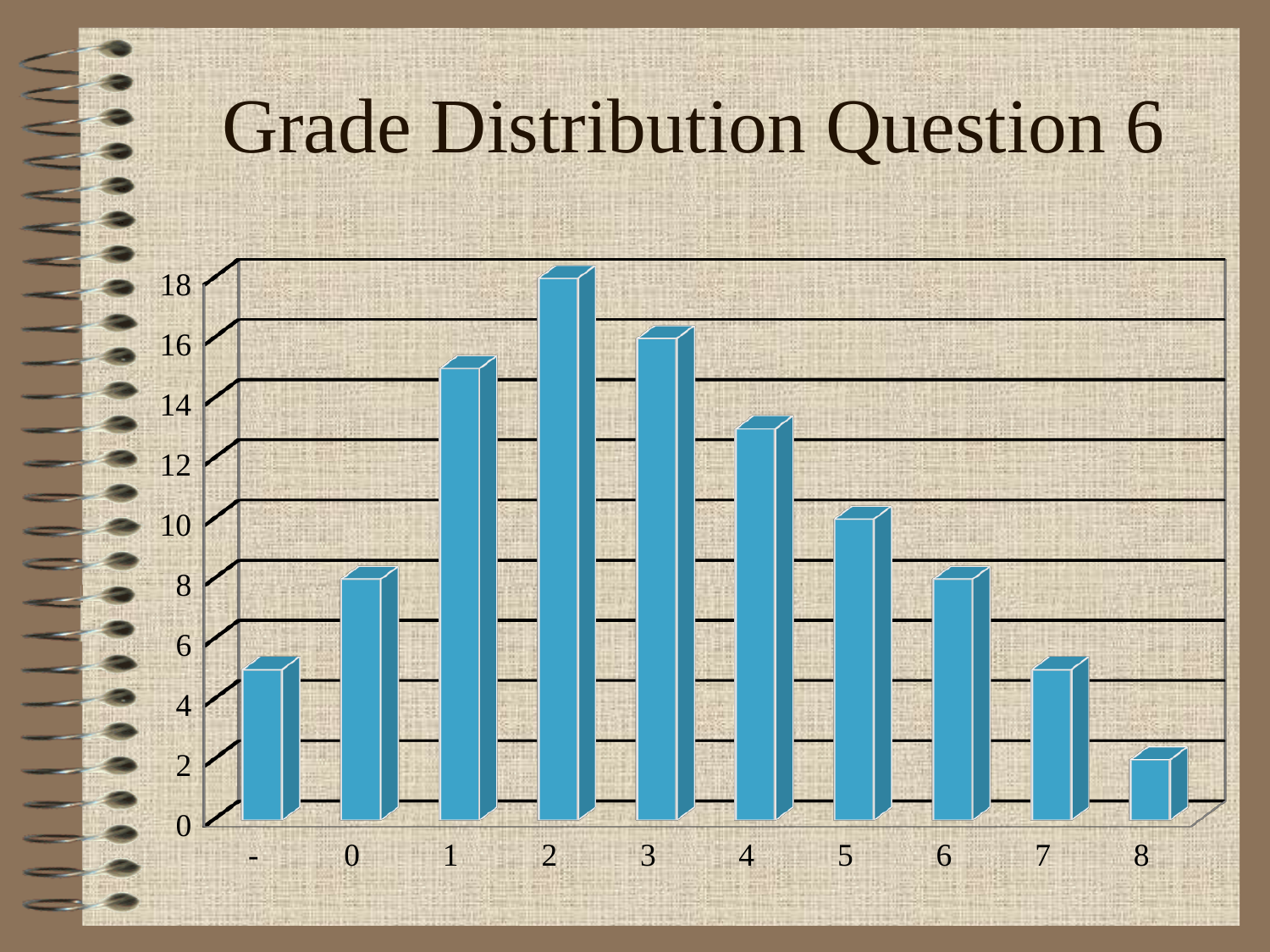
What is the value for category 3? 16 What is the value for category 8? 2 What is the value for category 2? 18 Do the values rise or fall along the x axis from category 2 to category 8? fall What is the difference between the values for category 2 and category 3? 2 What is the title of the chart? Grade Distribution Question 6 Which category has the lowest bar? 8 Is the value for category 1 greater or less than 14? greater Which category has the highest bar? 2 What type of chart is shown on the slide? bar chart Which is larger, the value for category 3 or the value for category 4? 3 How many categories are shown on the x axis? 10